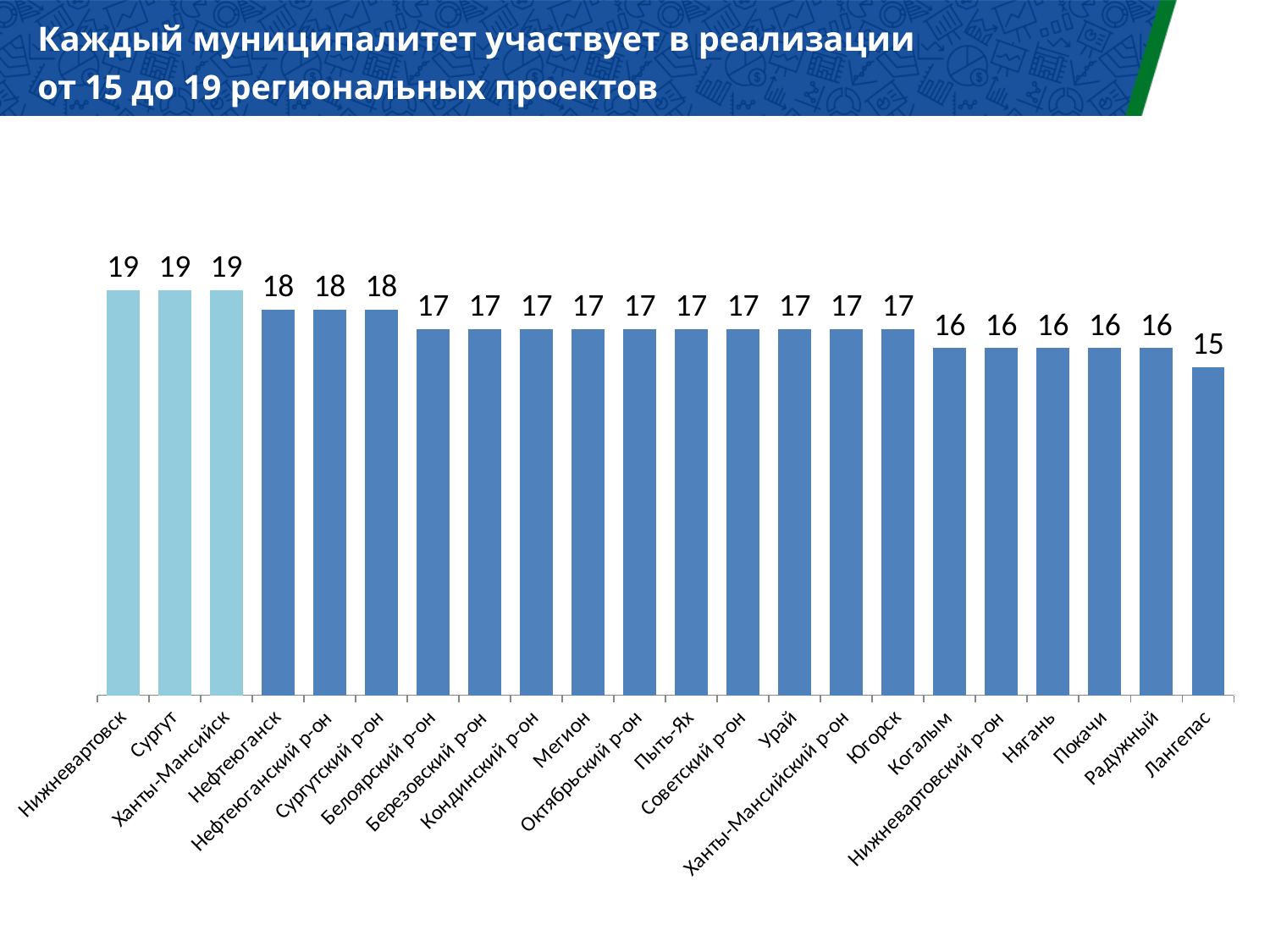
What kind of chart is shown on the slide? Bar chart Which is larger, the value for Ханты-Мансийск or the value for Югорск? Ханты-Мансийск What is the difference between the value for Сургутский р-он and the value for Нягань? 2 How many bars are coloured light blue rather than dark blue? 3 What value is shown for Мегион? 17 What value is shown for Когалым? 16 What value is shown for Нефтеюганск? 18 Which municipality has the lowest value? Лангепас What value is shown for Лангепас? 15 How many municipalities are shown on the chart? 22 Which is larger, the value for Покачи or the value for Урай? Урай What is the difference between the value for Сургут and the value for Лангепас? 4